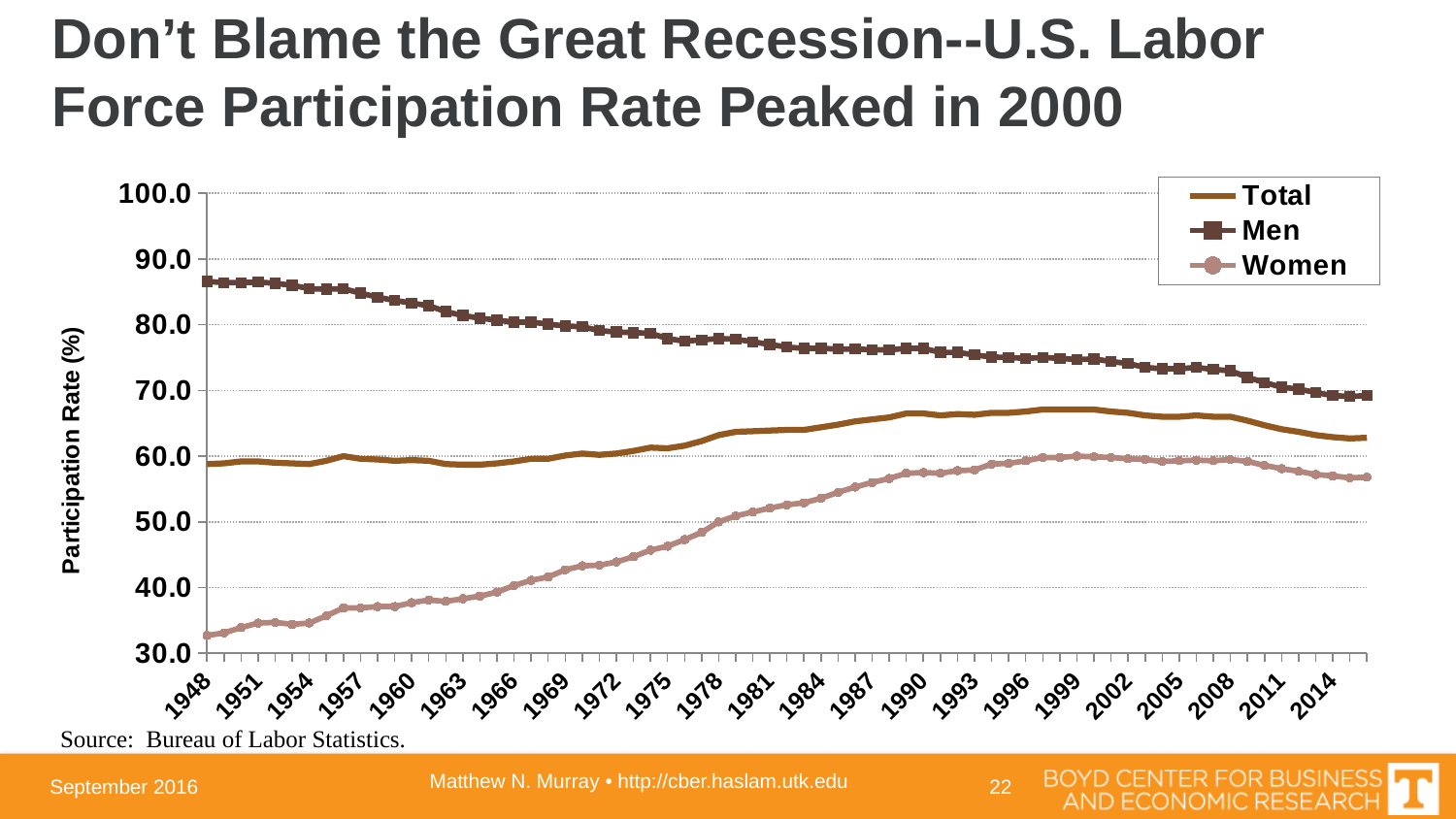
Which series has the lowest value in 1948? Women How many series does the legend list? 3 In 1948, which series has the larger value, Men or Women? Men Is the value for Total in 1999 greater or less than 60.0? greater Is the value for Men in 1948 greater or less than 80.0? greater What is the label on the vertical axis? Participation Rate (%) Does the Women series rise or fall from 1948 to 1999? Rise Which series does the legend list: name them. Total, Men, Women What kind of chart is shown on the slide? Line chart Does the Men series rise or fall from 1948 to 2014? Fall Is the value for Women in 1990 greater or less than 50.0? greater